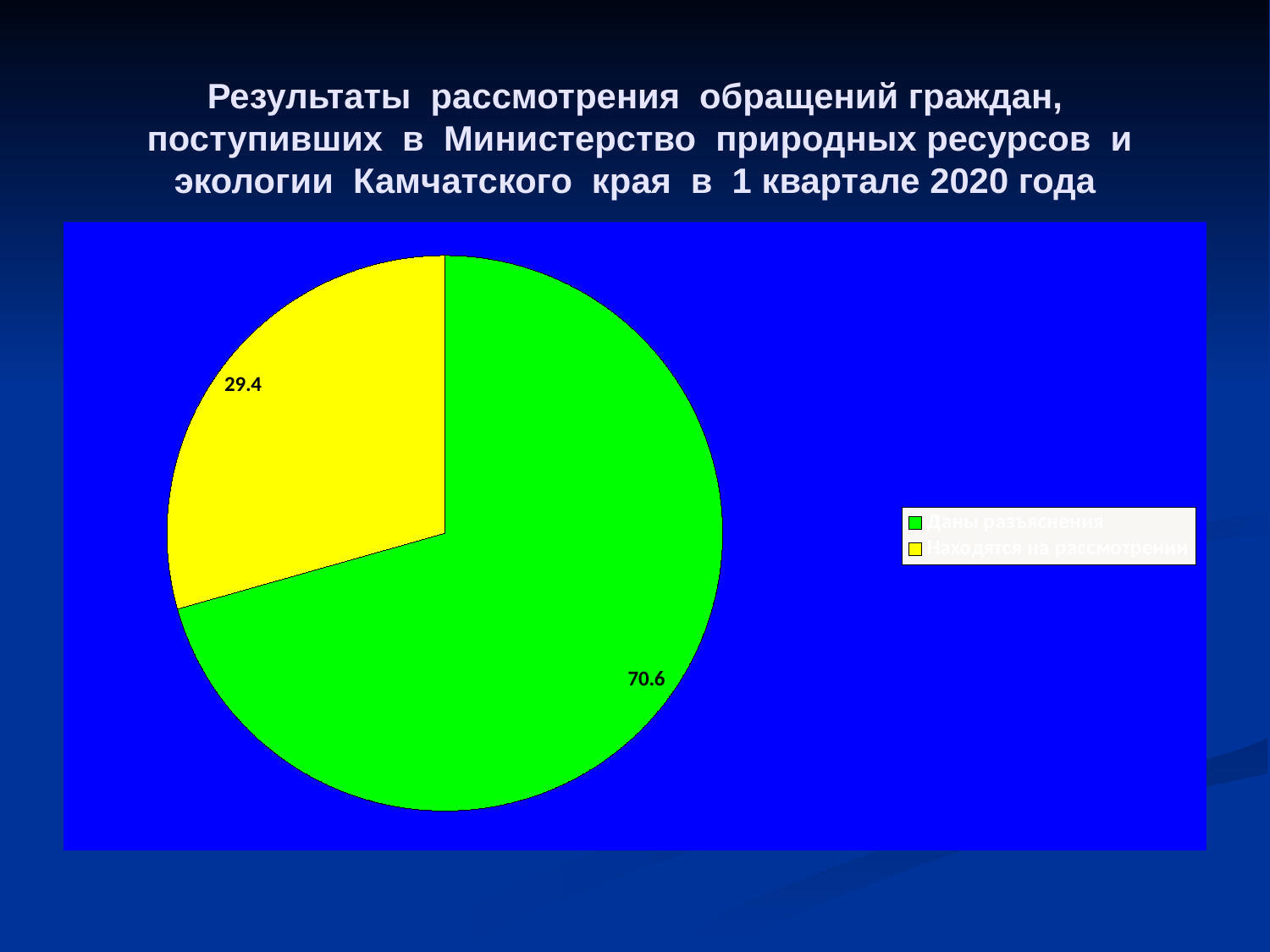
What value is shown for the yellow slice (Находятся на рассмотрении)? 29.4 What value is shown for the green slice (Даны разъяснения)? 70.6 Which category has the smallest slice of the pie? Находятся на рассмотрении What is the difference between the values for Даны разъяснения and Находятся на рассмотрении? 41.2 How many slices does the pie chart have? 2 Which colour represents Находятся на рассмотрении in the pie chart? yellow How many entries does the legend of the pie chart list? 2 Which category has the largest slice of the pie? Даны разъяснения Which colour represents Даны разъяснения in the pie chart? green Which is larger: the slice for Даны разъяснения or the slice for Находятся на рассмотрении? Даны разъяснения What is the total of the two values shown on the pie chart? 100 What kind of chart is shown on the slide? pie chart